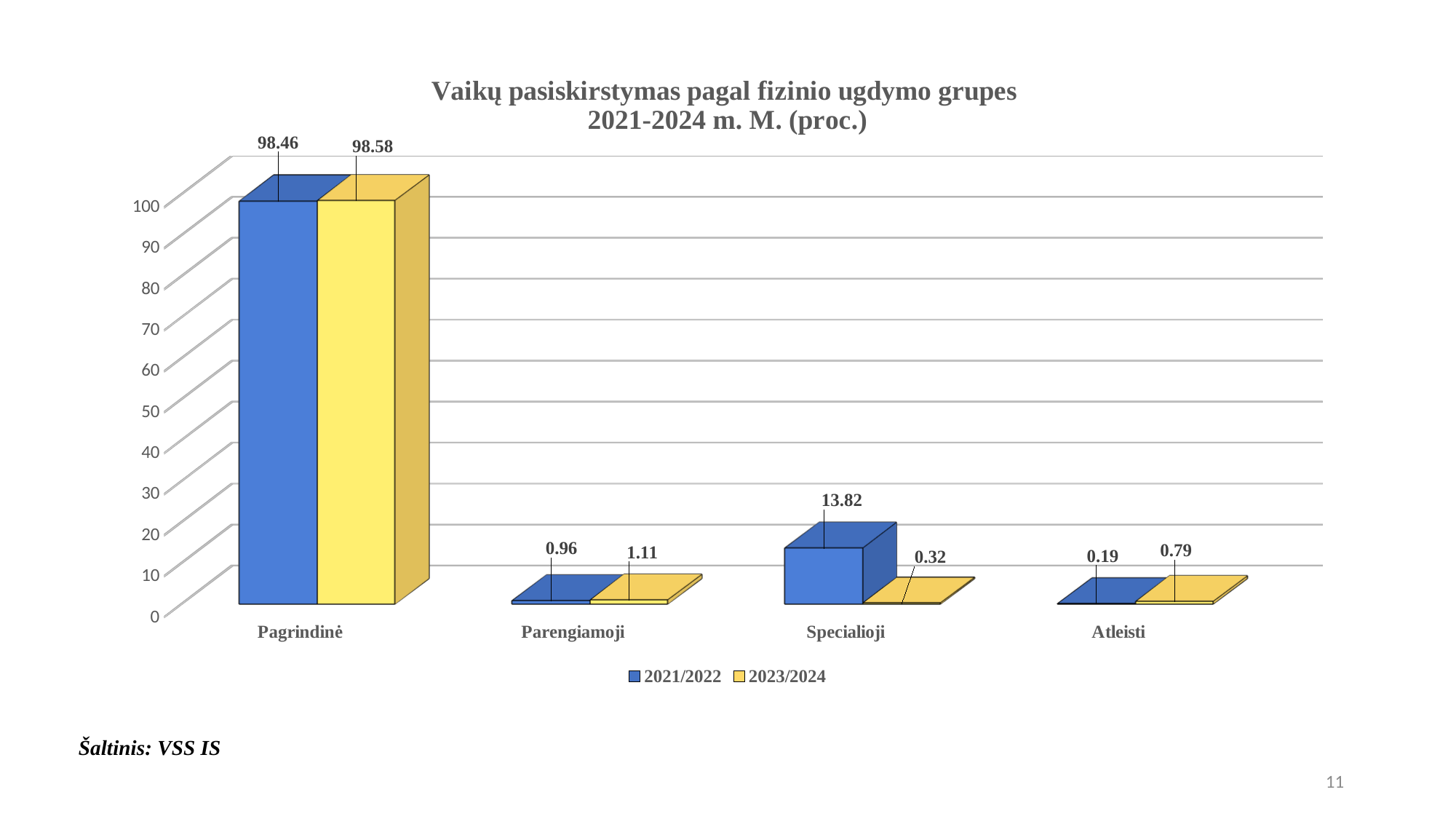
How many series does the legend list? 2 What kind of chart is shown on the slide? Bar chart Which colour represents the 2023/2024 series? Yellow Which category has the highest value in the 2023/2024 series? Pagrindinė How many categories are shown on the x axis? 4 What is the difference between the 2021/2022 and 2023/2024 values for Specialioji? 13.50 Which category has the lowest value in the 2021/2022 series? Atleisti What is the value for Pagrindinė in the 2021/2022 series? 98.46 Which is larger for Atleisti: the 2021/2022 value or the 2023/2024 value? 2023/2024 What is the value for Parengiamoji in the 2023/2024 series? 1.11 What is the value for Atleisti in the 2021/2022 series? 0.19 What is the value for Specialioji in the 2023/2024 series? 0.32